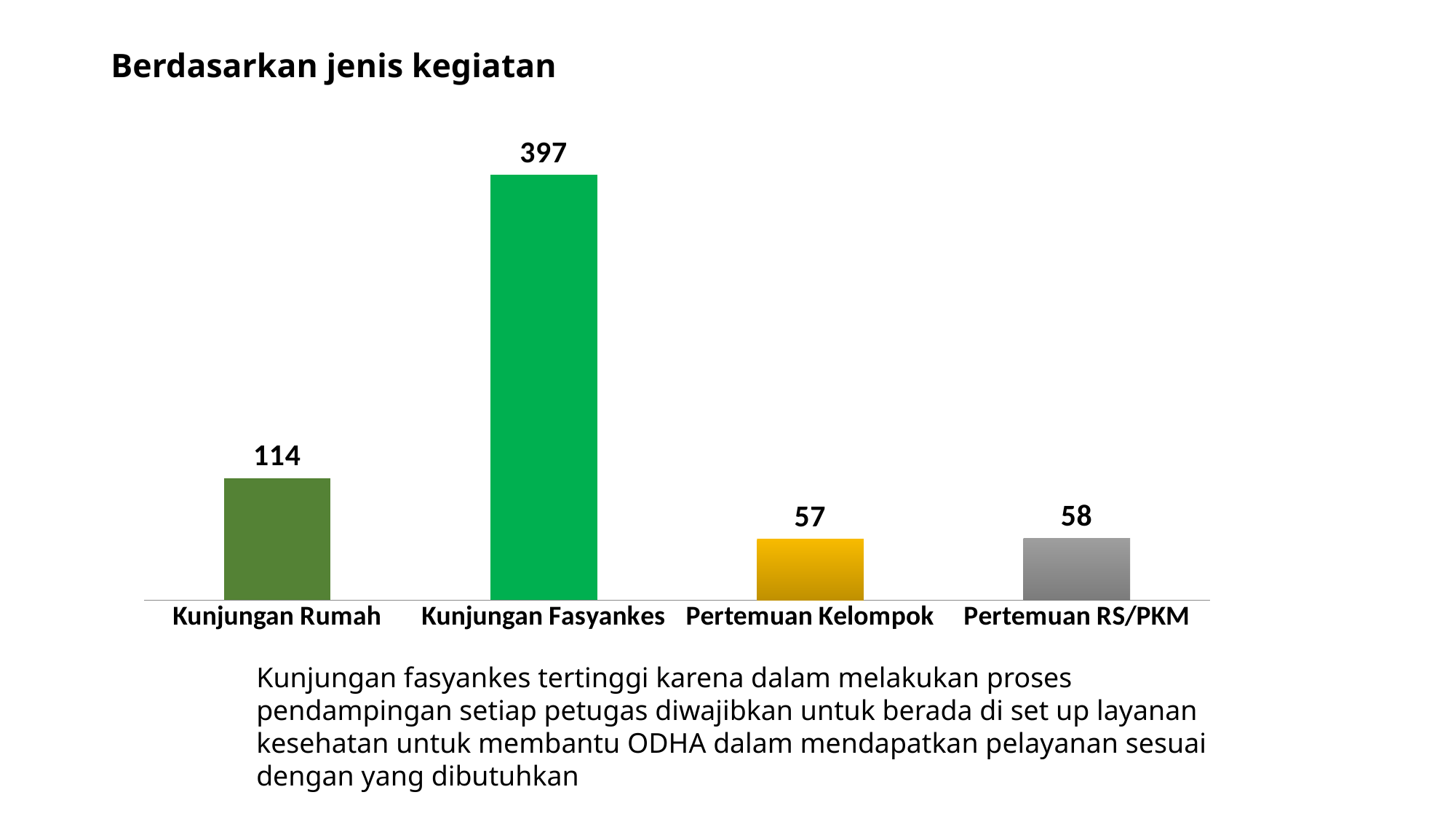
Which category has the highest value? Kunjungan Fasyankes What is the value for Pertemuan Kelompok? 57 How many categories are shown in the chart? 4 What kind of chart is shown on the slide? Bar chart What is the title of the chart? Berdasarkan jenis kegiatan What colour is the bar for Pertemuan Kelompok? Yellow What is the difference between the values for Pertemuan RS/PKM and Pertemuan Kelompok? 1 Which is larger, the value for Kunjungan Rumah or the value for Pertemuan Kelompok? Kunjungan Rumah What is the value for Kunjungan Rumah? 114 What is the difference between the values for Kunjungan Fasyankes and Kunjungan Rumah? 283 What is the value for Kunjungan Fasyankes? 397 What is the value for Pertemuan RS/PKM? 58